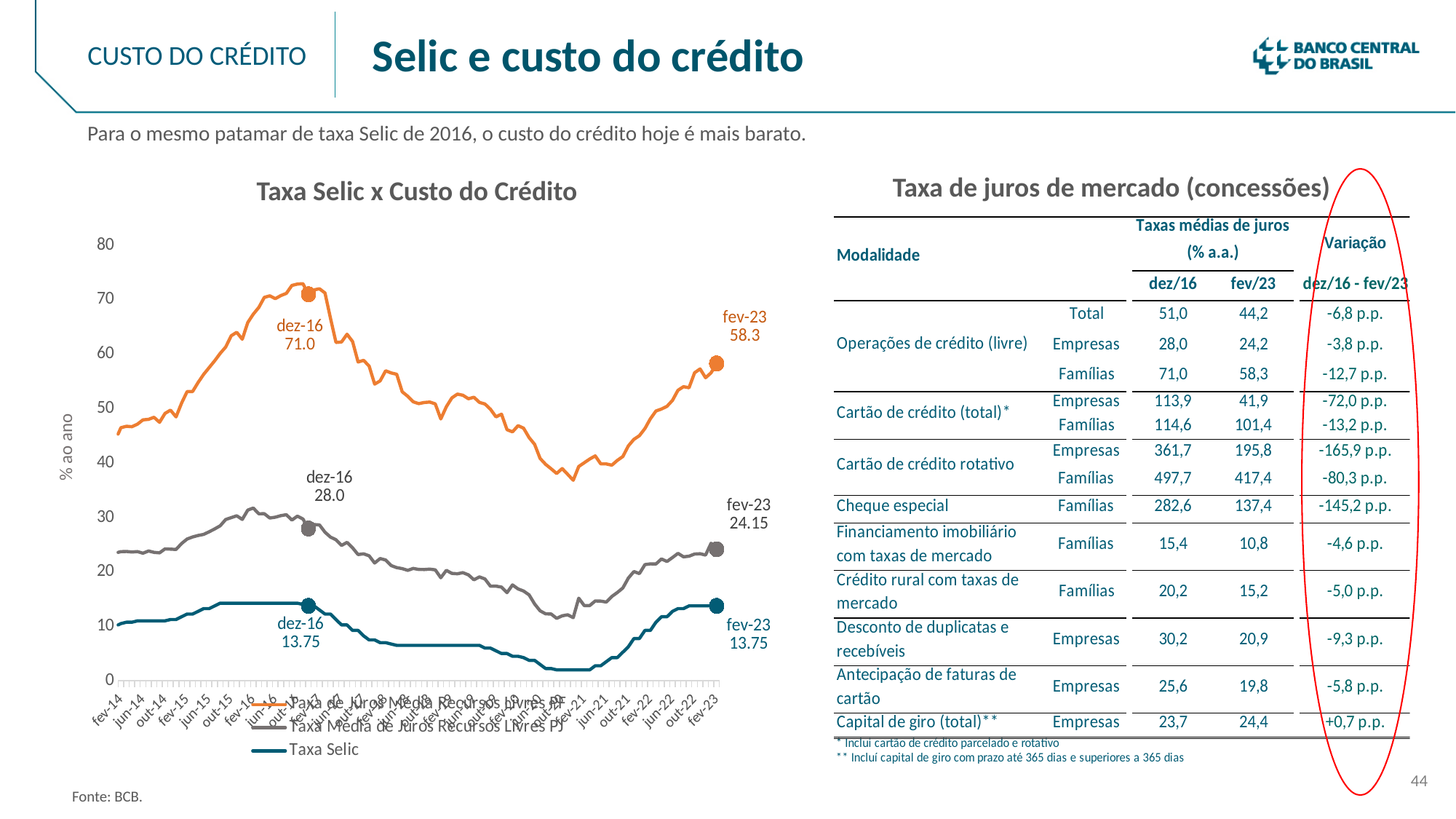
In the "Taxa Selic x Custo do Crédito" chart, is the labelled Taxa Selic value in fev-23 higher, lower or the same as in dez-16? the same In the "Taxa Selic x Custo do Crédito" chart, by how much did Taxa Média de Juros Recursos Livres PF fall from dez-16 (71.0) to fev-23 (58.3)? 12.7 In the "Taxa Selic x Custo do Crédito" chart, what is the labelled value of Taxa Média de Juros Recursos Livres PJ in dez-16? 28.0 In the "Taxa Selic x Custo do Crédito" chart, what is the labelled value of Taxa Selic in dez-16? 13.75 In the "Taxa Selic x Custo do Crédito" chart, what is the labelled value of Taxa Média de Juros Recursos Livres PJ in fev-23? 24.15 What is the y-axis label of the "Taxa Selic x Custo do Crédito" chart? % ao ano What type of chart is "Taxa Selic x Custo do Crédito"? line chart In the "Taxa Selic x Custo do Crédito" chart, is the Taxa Selic value in fev-21 greater or less than 10? less In the "Taxa Selic x Custo do Crédito" chart, what is the difference between the PJ values labelled in dez-16 (28.0) and fev-23 (24.15)? 3.85 In the "Taxa Selic x Custo do Crédito" chart, what is the labelled value of Taxa Média de Juros Recursos Livres PF in fev-23? 58.3 In the "Taxa Selic x Custo do Crédito" chart, which series has the highest value in dez-16? Taxa Média de Juros Recursos Livres PF How many series does the legend of the "Taxa Selic x Custo do Crédito" chart list? 3